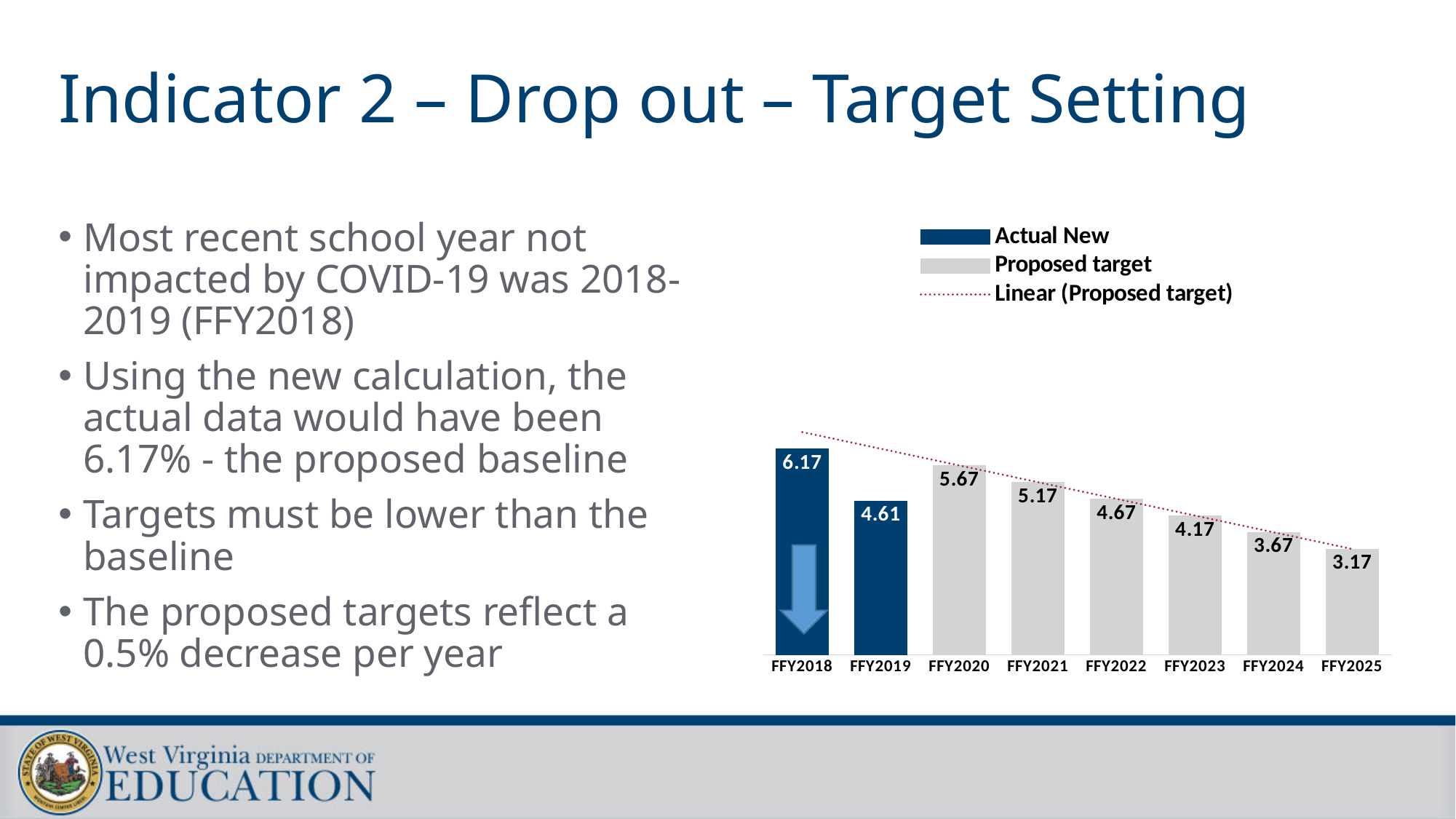
Which year has the lowest value in the chart? FFY2025 Which is larger, the value for FFY2019 or the proposed target for FFY2020? The proposed target for FFY2020 (5.67) What is the value for FFY2019 in the chart? 4.61 How many years are shown on the x axis of the chart? 8 What kind of chart is shown on the slide? Bar chart What is the value for FFY2018 in the chart? 6.17 What is the proposed target for FFY2025? 3.17 What is the proposed target for FFY2022? 4.67 How many entries does the chart legend list? 3 What is the difference between the FFY2018 value and the FFY2019 value? 1.56 Which year has the highest value in the chart? FFY2018 What is the difference between the proposed targets for FFY2020 and FFY2025? 2.50